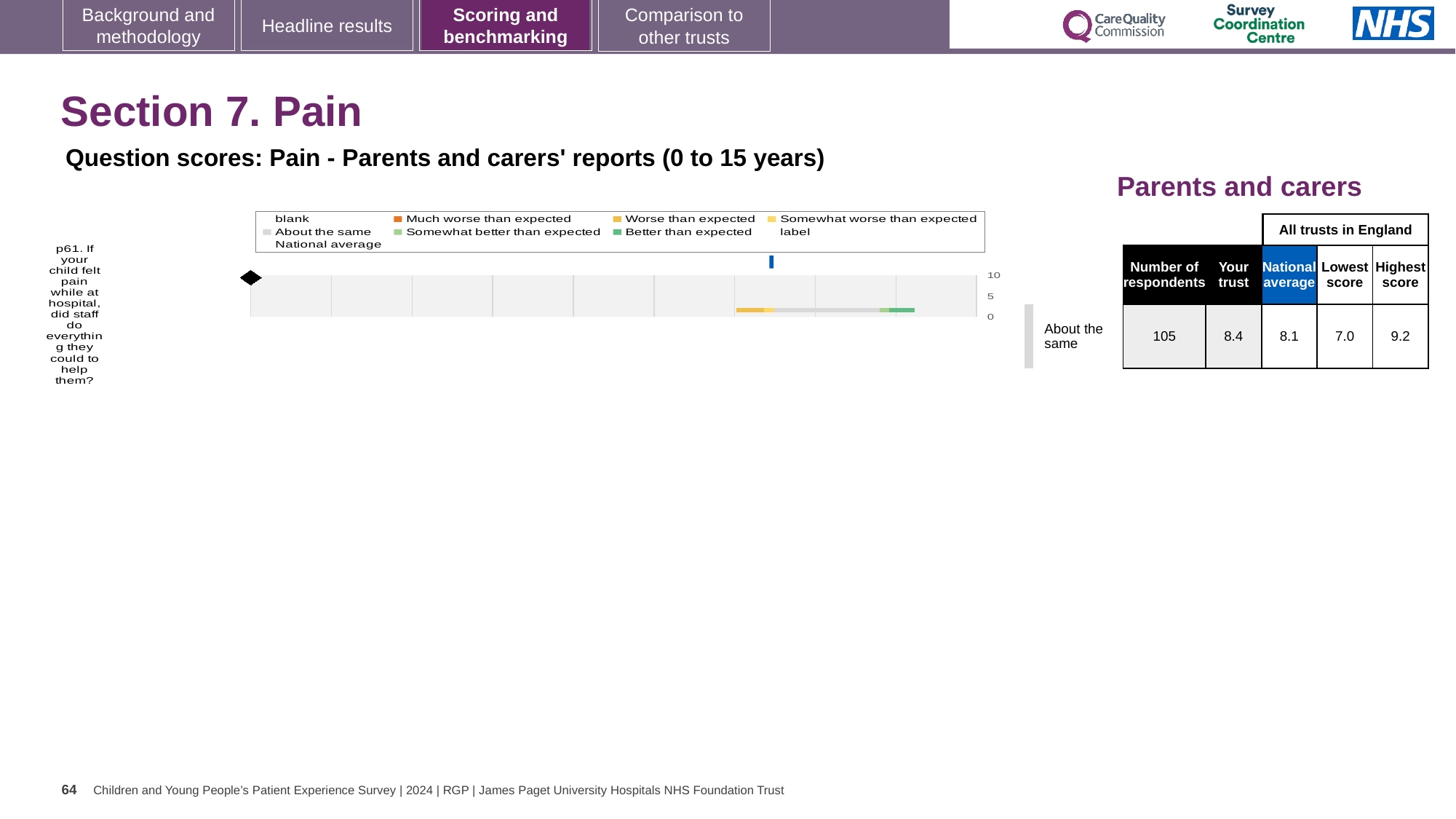
What kind of chart is shown on the slide for question p61? bar chart In the table beside the chart, what is the highest score among all trusts in England for question p61? 9.2 In the table beside the chart, how many respondents answered question p61? 105 Which survey question is plotted in the chart on this slide? p61. If your child felt pain while at hospital, did staff do everything they could to help them? What is the highest tick value shown on the chart's numeric axis? 10 In the table beside the chart, what is the national average score for question p61? 8.1 What benchmark category is given for question p61 next to the chart? About the same In the table beside the chart, what is the lowest score among all trusts in England for question p61? 7.0 For question p61, what is the difference between the highest score and the lowest score among all trusts in England? 2.2 How many survey questions are plotted in the chart on this slide? 1 For question p61, which is larger: the 'Your trust' score or the national average? Your trust In the table beside the chart, what is the 'Your trust' score for question p61? 8.4